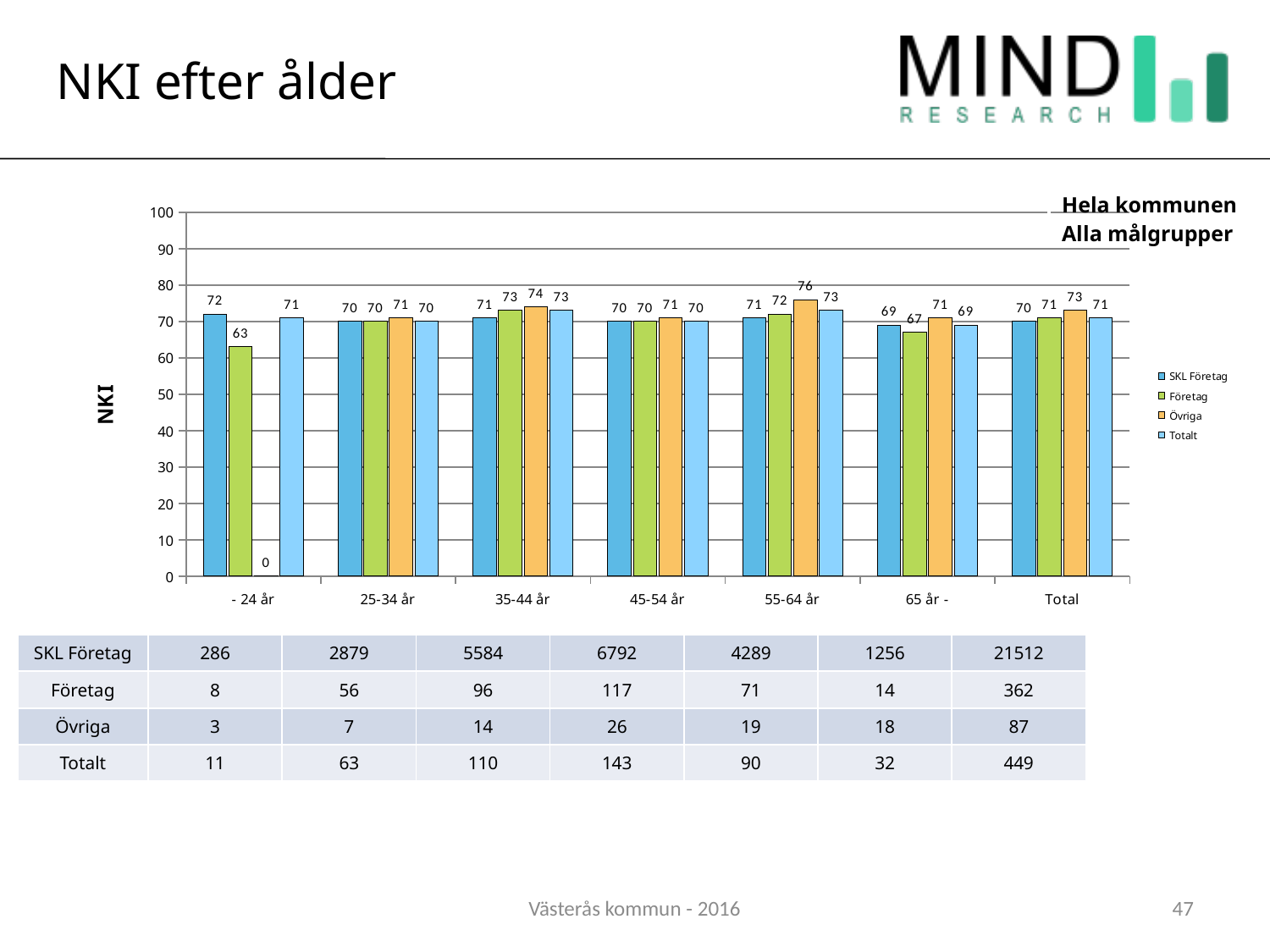
What is the NKI value for Övriga in the '55-64 år' age group? 76 What is the difference between the SKL Företag value and the Företag value in the '- 24 år' age group? 9 What is the NKI value for SKL Företag in the '- 24 år' age group? 72 How many age-group categories are shown on the x axis of the chart? 7 Which is larger in the '65 år -' age group: the Övriga value or the Företag value? Övriga What is the title of the chart on the slide? NKI efter ålder What kind of chart is shown on the slide? Bar chart How many series does the chart legend list? 4 Which age group has the highest Övriga value? 55-64 år What is the NKI value for Företag in the '65 år -' age group? 67 What is the NKI value for Totalt in the '35-44 år' age group? 73 Which age group has the lowest Företag value? - 24 år